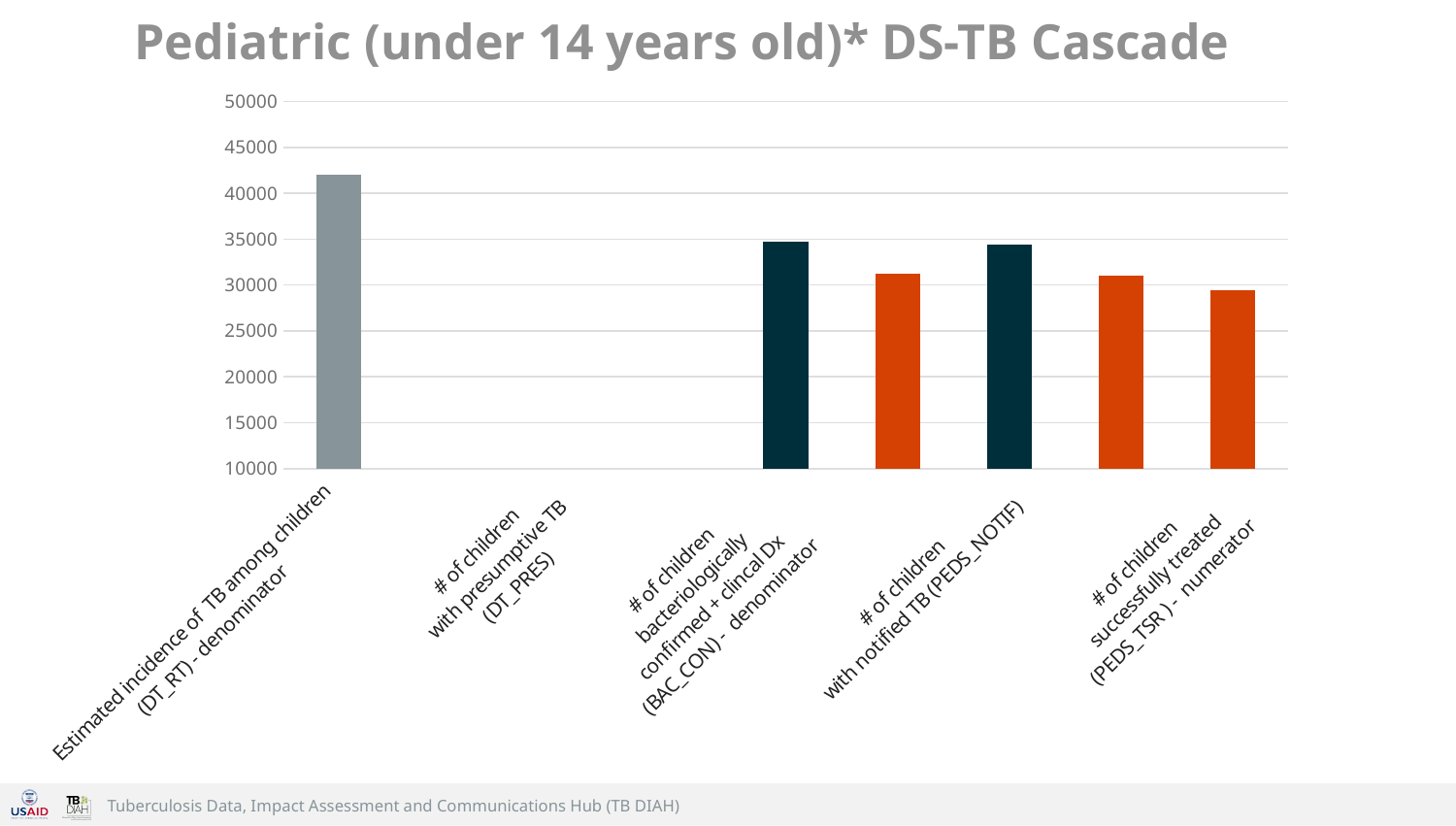
Do the bar values generally rise or fall from left to right across the chart? fall Is the dark bar for # of children bacteriologically confirmed + clinical Dx (BAC_CON) - denominator greater or less than 30000? greater Which is larger: the bar for Estimated incidence of TB among children (DT_RT) - denominator or the bar for # of children successfully treated (PEDS_TSR) - numerator? Estimated incidence of TB among children (DT_RT) - denominator Is the value for # of children successfully treated (PEDS_TSR) - numerator greater or less than 35000? less Is the value for Estimated incidence of TB among children (DT_RT) - denominator greater or less than 40000? greater How many bars are plotted in the chart? 6 What kind of chart is shown on the slide? bar chart What is the title of the chart? Pediatric (under 14 years old)* DS-TB Cascade Which category has the tallest bar? Estimated incidence of TB among children (DT_RT) - denominator How many category labels are shown along the x axis? 5 Which category has no bar plotted? # of children with presumptive TB (DT_PRES)